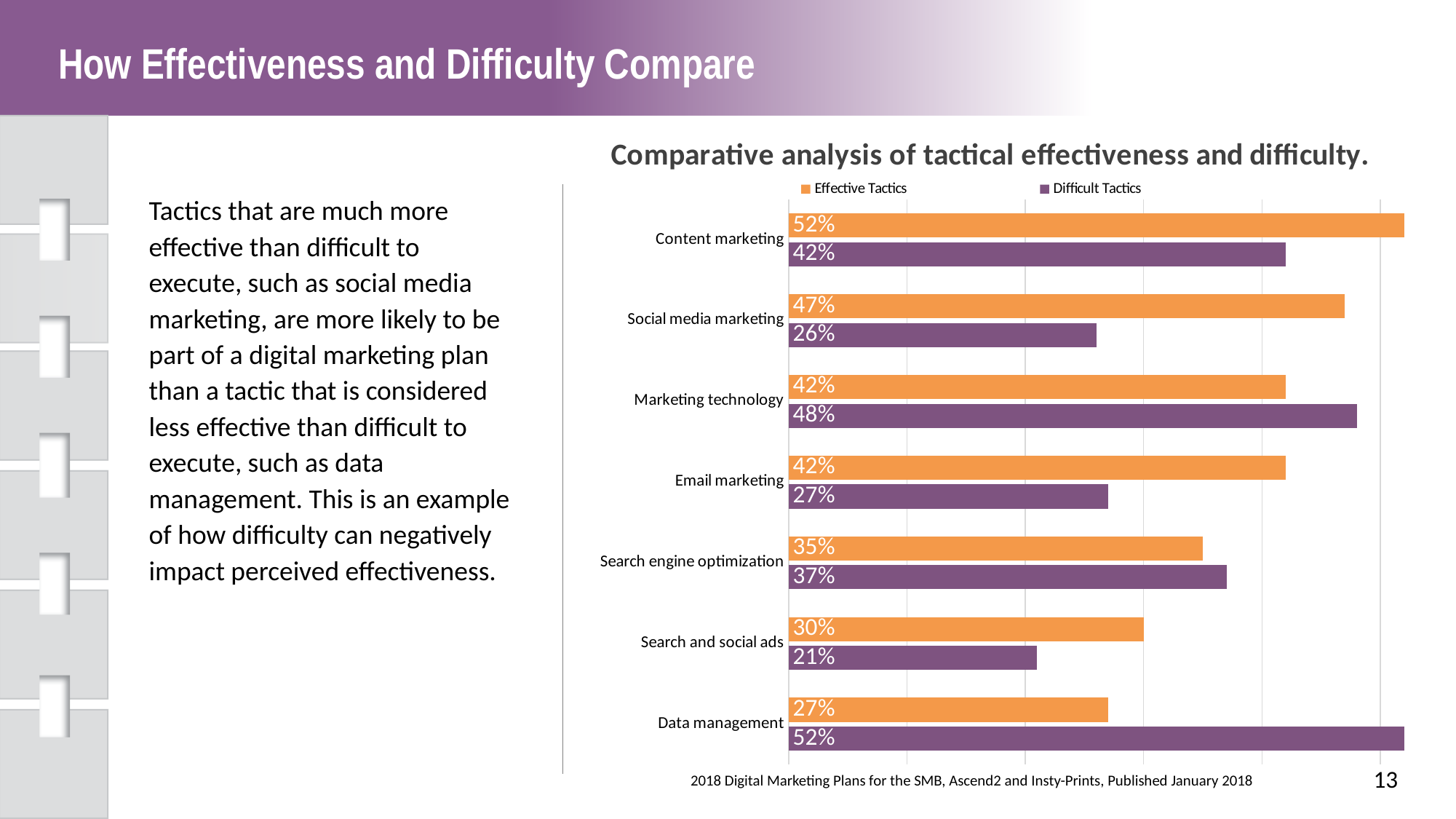
What is the Difficult Tactics value for Email marketing? 27% How many series does the legend list? 2 What is the Difficult Tactics value for Data management? 52% What is the difference between the Effective Tactics and Difficult Tactics values for Social media marketing? 21% Which category has the lowest Effective Tactics value? Data management What is the difference between the Difficult Tactics and Effective Tactics values for Data management? 25% For Marketing technology, which is larger: the Effective Tactics value or the Difficult Tactics value? Difficult Tactics Which category has the lowest Difficult Tactics value? Search and social ads How many categories are shown on the chart? 7 What is the Effective Tactics value for Social media marketing? 47% What kind of chart is shown on the slide? Bar chart Which category has the highest Effective Tactics value? Content marketing